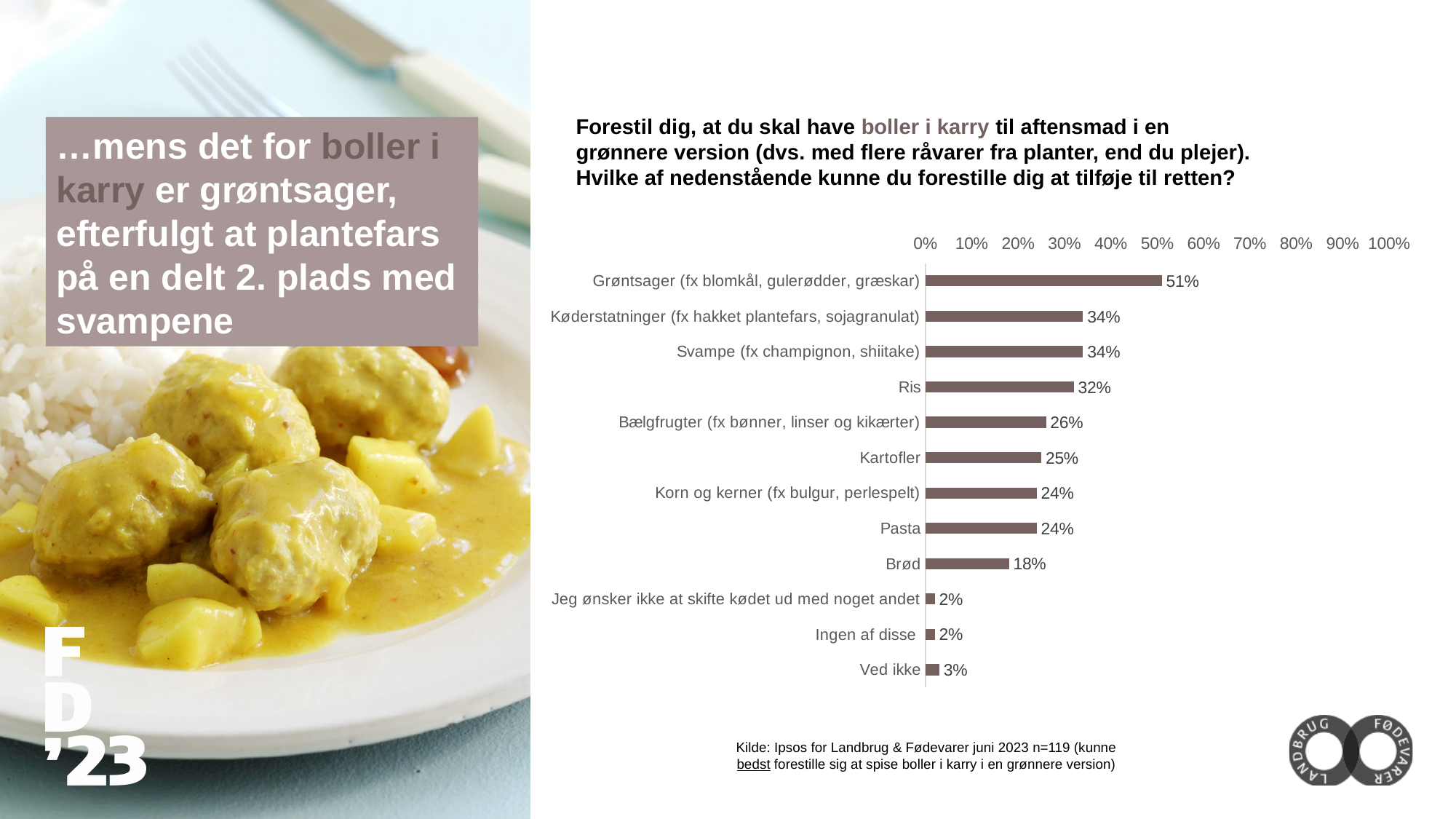
What is the difference between the values for Grøntsager and Svampe? 17% Which is larger, the value for Bælgfrugter or the value for Pasta? Bælgfrugter What is the value for Brød? 18% Is the value for Grøntsager greater or less than 50%? greater What is the value for Grøntsager (fx blomkål, gulerødder, græskar)? 51% How many categories are shown in the chart? 12 What kind of chart is shown on the slide? bar chart Which category has the highest value? Grøntsager (fx blomkål, gulerødder, græskar) What is the value for Kartofler? 25% What is the difference between the values for Ris and Brød? 14% What is the value for Ris? 32% What is the value for Ved ikke? 3%